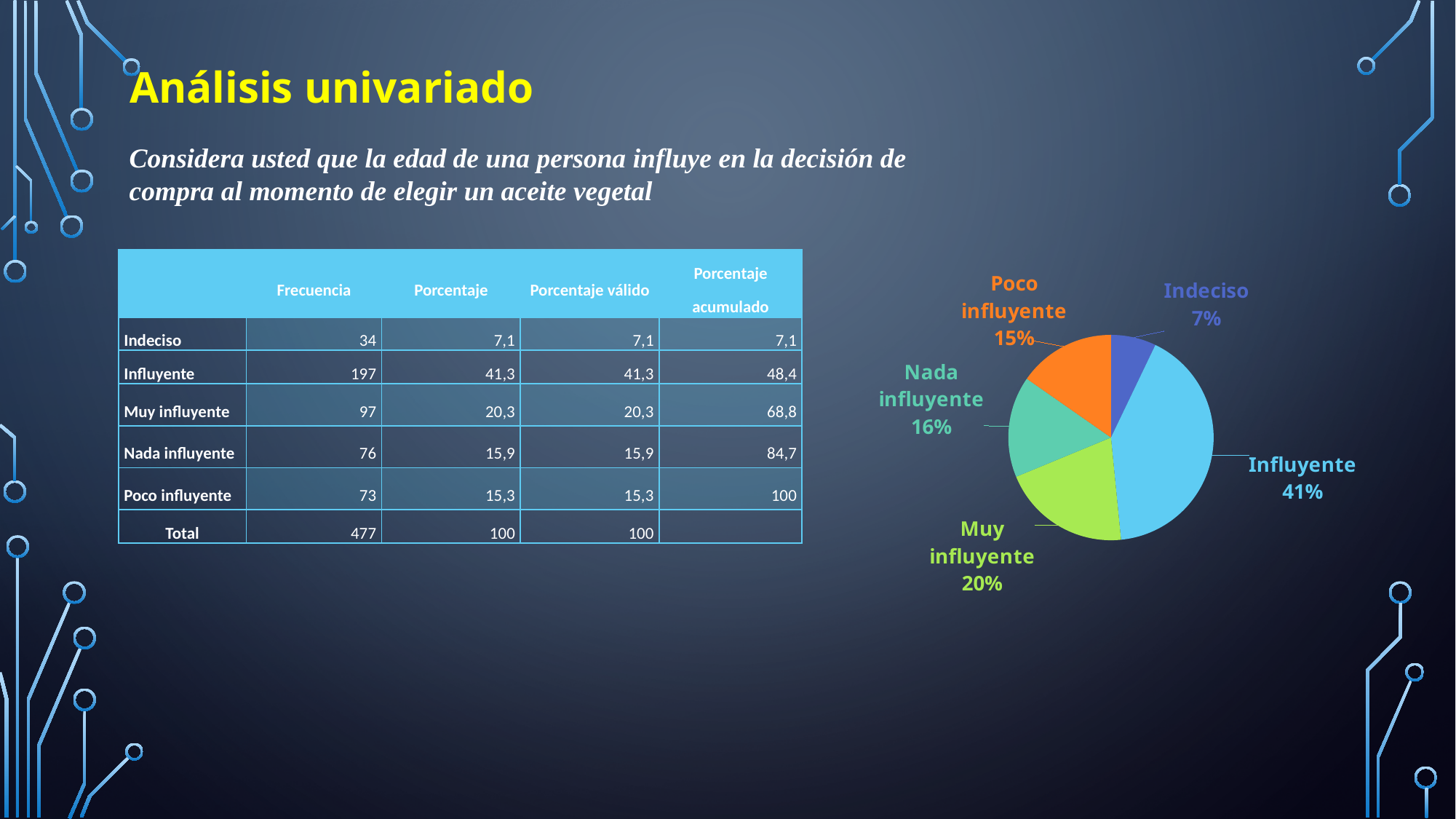
How many slices does the pie chart have? 5 What share of the pie does Influyente have? 41% What colour is the Poco influyente slice? orange What kind of chart is shown on the slide? pie chart What is the difference in percentage points between Influyente and Muy influyente? 21 What share of the pie does Muy influyente have? 20% Which is larger, the slice for Nada influyente or the slice for Indeciso? Nada influyente What share of the pie does Poco influyente have? 15% Which category has the largest slice of the pie? Influyente Which category has the smallest slice of the pie? Indeciso